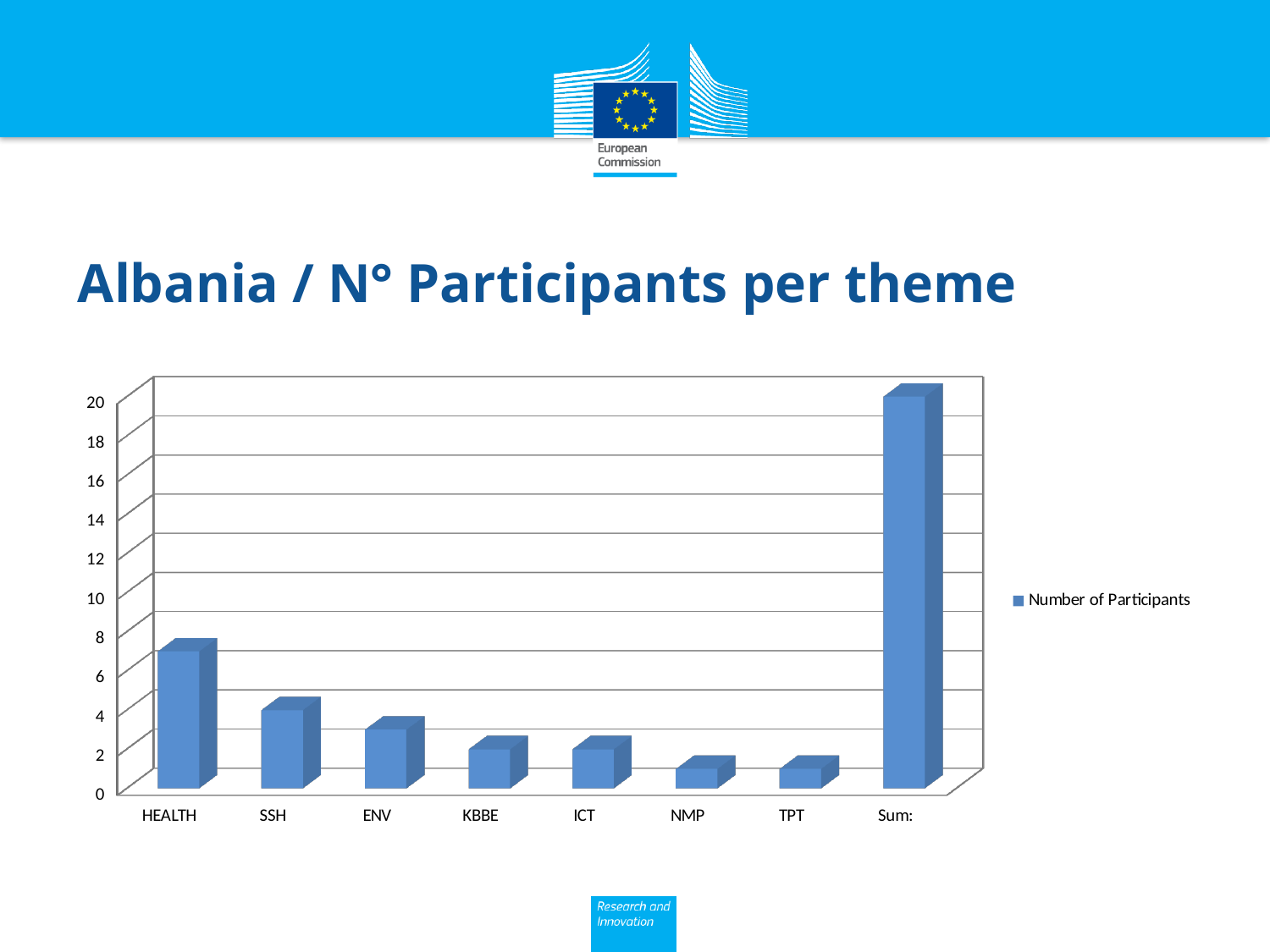
Excluding the Sum: bar, which theme has the highest number of participants? HEALTH How many categories are shown on the x axis of the chart? 8 Is the value for SSH greater or less than 6? less What kind of chart is shown on the slide? bar chart Is the value for NMP greater or less than 2? less Is the value for Sum: greater or less than 18? greater What is the legend entry for the series in the chart? Number of Participants Which category has the tallest bar in the chart? Sum: What is the title of the slide containing the chart? Albania / N° Participants per theme Which has more participants, HEALTH or SSH? HEALTH How many series does the legend list? 1